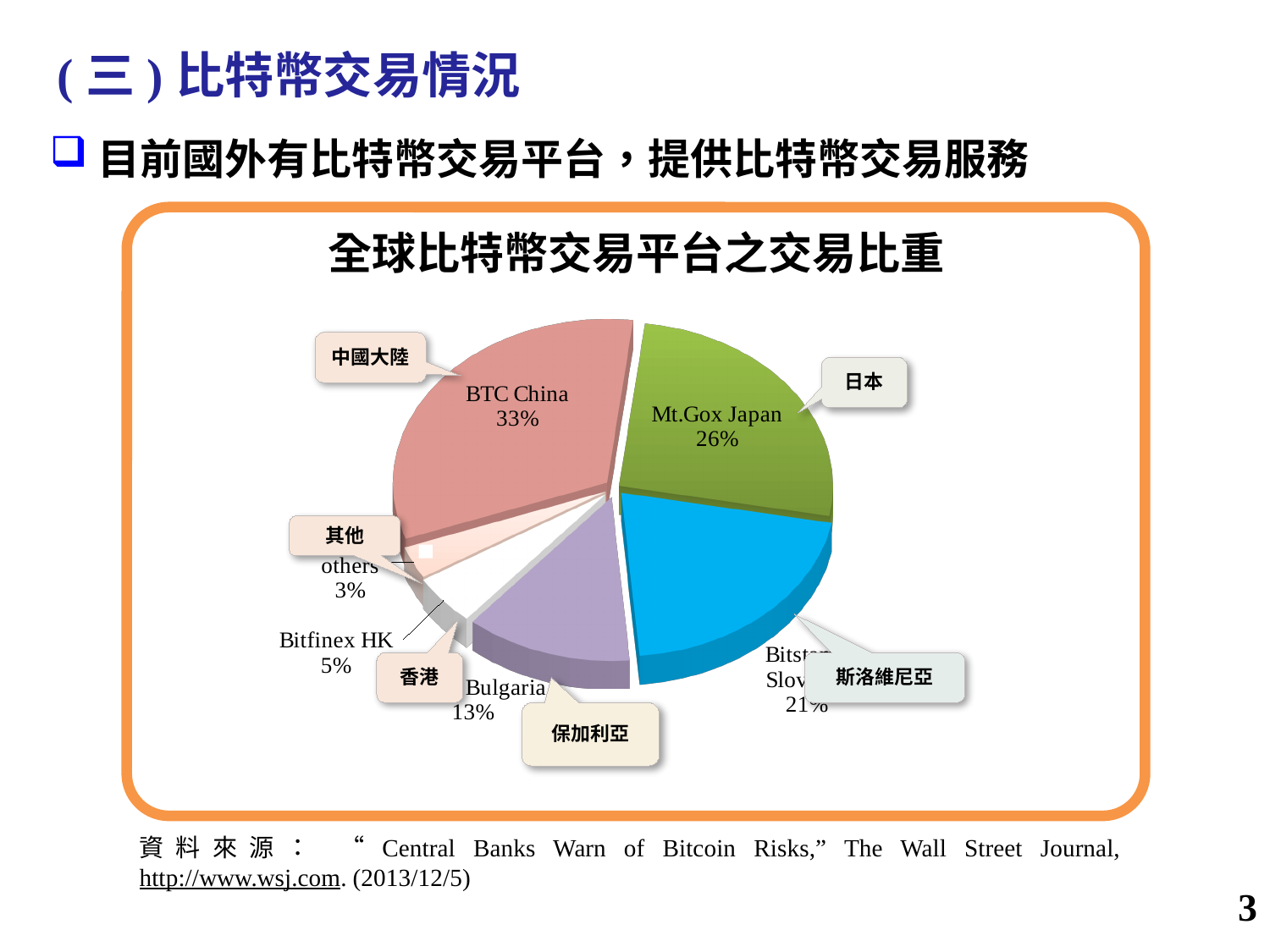
What is the title of the pie chart? 全球比特幣交易平台之交易比重 Which slice has the smallest share of the pie? others How many slices does the pie chart have? 6 What percentage is shown for Mt.Gox Japan? 26% Which slice has the largest share of the pie? BTC China How many percentage points larger is BTC China's share than Mt.Gox Japan's? 7 percentage points What percentage is shown for Bulgaria? 13% What percentage is shown for Bitfinex HK? 5% What kind of chart is shown on the slide? Pie chart What share of the pie does BTC China hold? 33% What percentage is shown for the 'others' slice? 3% Which has the larger share, Bulgaria or Bitfinex HK? Bulgaria